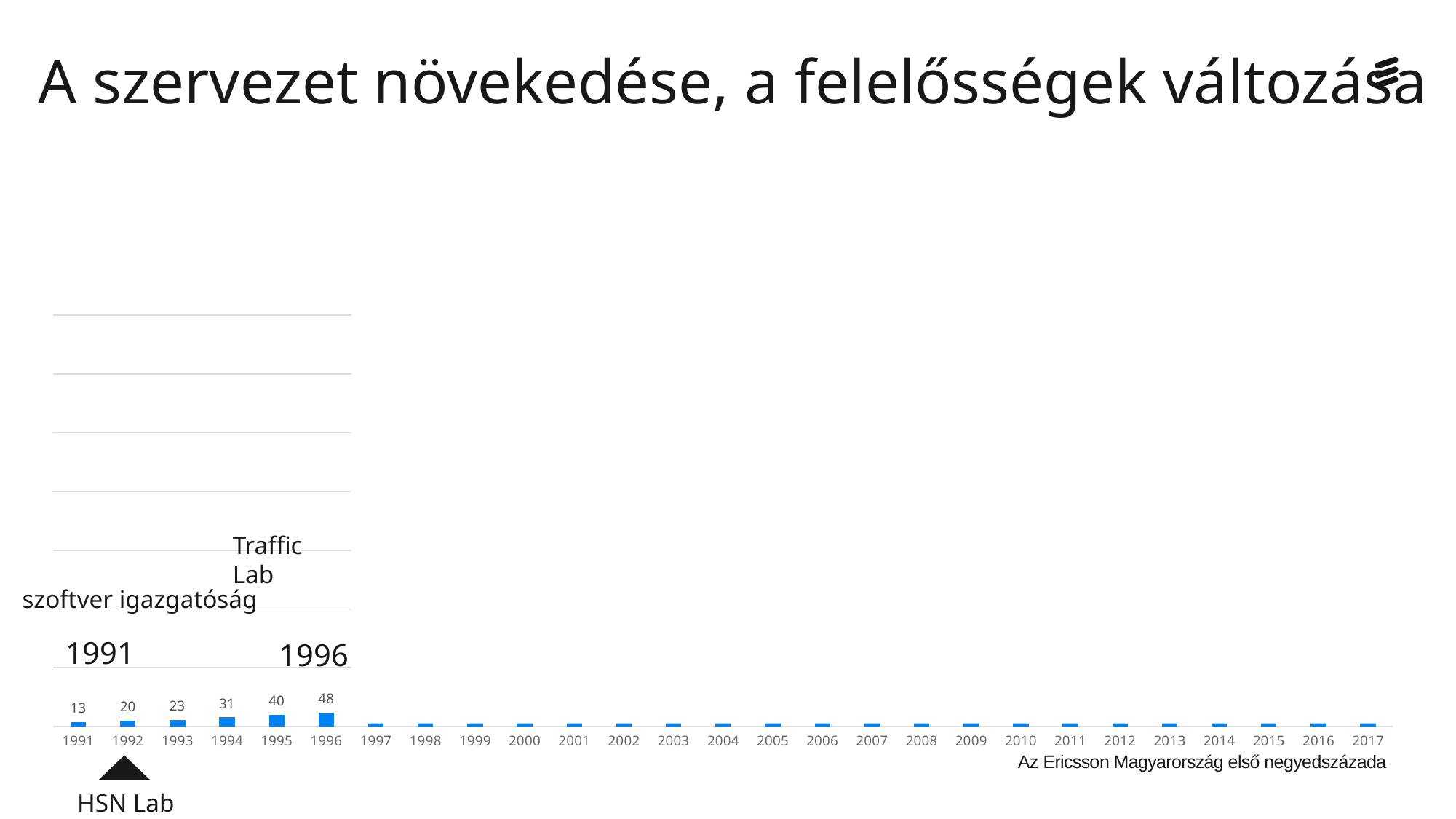
What is the difference between the values for 1995 and 1994? 9 What is the difference between the values for 1996 and 1991? 35 What value is shown for 1994? 31 How many years are shown on the x axis? 27 Which is larger, the value for 1992 or the value for 1995? 1995 Among the years with printed values, which year has the lowest value? 1991 What value is shown for 1991? 13 Among the years with printed values, which year has the highest value? 1996 What value is shown for 1996? 48 Do the labelled values rise or fall from 1991 to 1996? rise What kind of chart is shown on the slide? bar chart What value is shown for 1993? 23